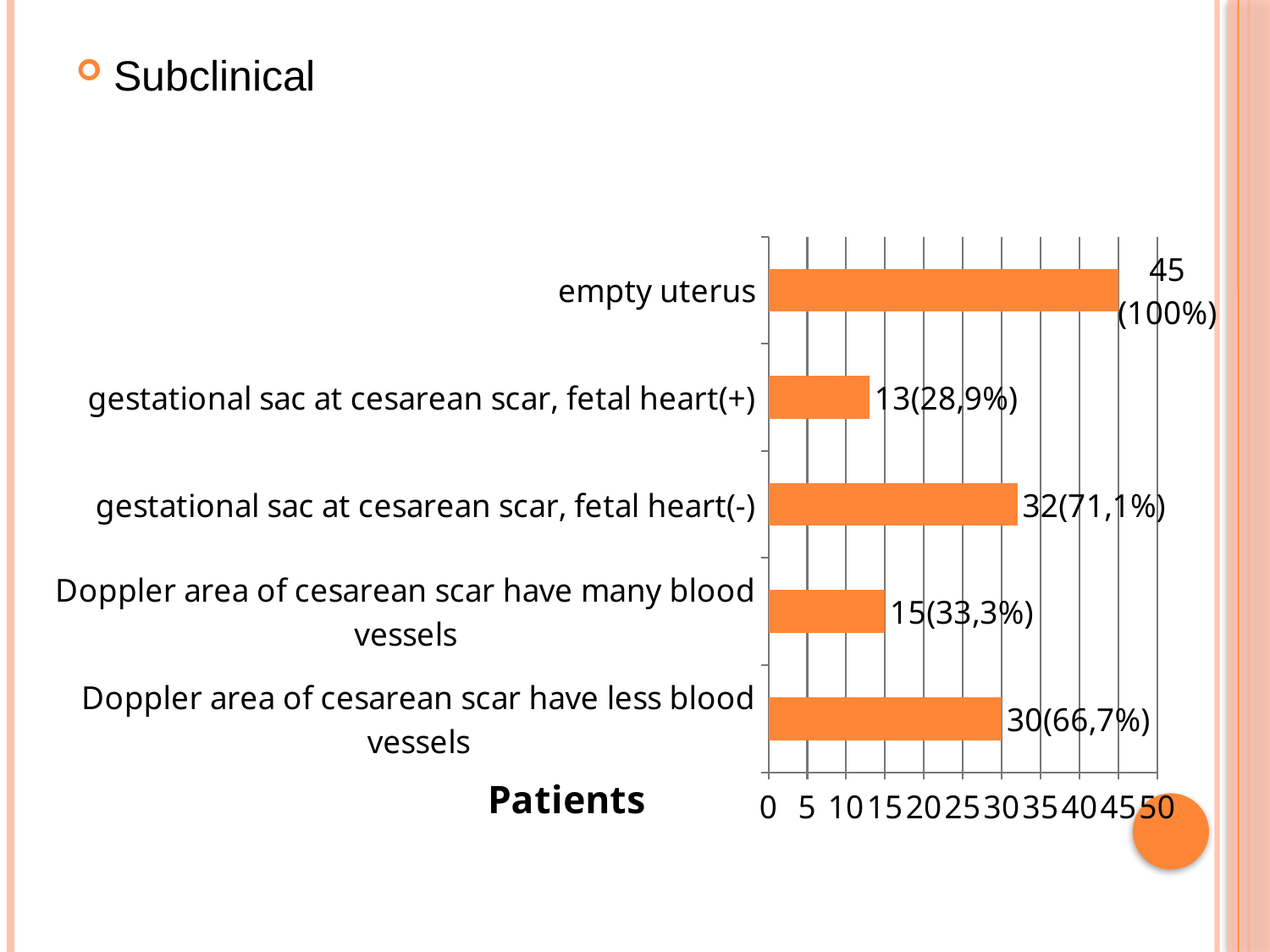
What is the label of the horizontal axis? Patients Which category has the lowest number of patients? gestational sac at cesarean scar, fetal heart(+) How many categories are shown in the chart? 5 Which has more patients: Doppler area of cesarean scar have less blood vessels or Doppler area of cesarean scar have many blood vessels? Doppler area of cesarean scar have less blood vessels What is the difference in patients between gestational sac at cesarean scar, fetal heart(-) and gestational sac at cesarean scar, fetal heart(+)? 19 What kind of chart is shown on the slide? bar chart What is the value for gestational sac at cesarean scar, fetal heart(+)? 13(28,9%) What is the value for Doppler area of cesarean scar have many blood vessels? 15(33,3%) What is the value for gestational sac at cesarean scar, fetal heart(-)? 32(71,1%) What is the value for empty uterus? 45 (100%) Which category has the highest number of patients? empty uterus What is the value for Doppler area of cesarean scar have less blood vessels? 30(66,7%)